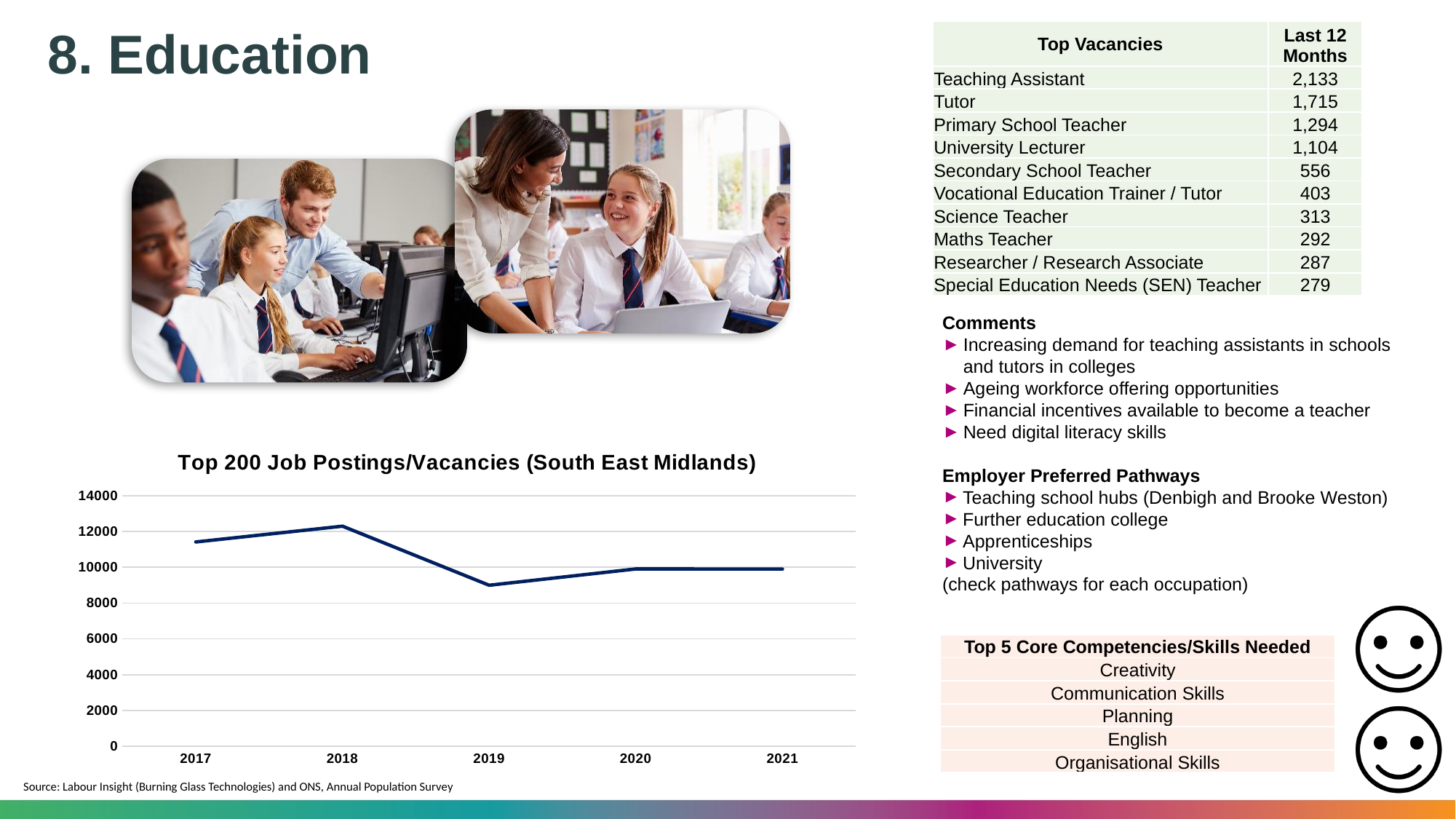
What is the title of the line chart on the slide? Top 200 Job Postings/Vacancies (South East Midlands) In the 'Top 200 Job Postings/Vacancies (South East Midlands)' chart, is the value for 2019 greater or less than 8000? greater In the 'Top 200 Job Postings/Vacancies (South East Midlands)' chart, does the value rise or fall from 2017 to 2018? rise In the 'Top 200 Job Postings/Vacancies (South East Midlands)' chart, which is larger, the value for 2018 or the value for 2019? 2018 In the 'Top 200 Job Postings/Vacancies (South East Midlands)' chart, is the value for 2018 greater or less than 12000? greater In the 'Top 200 Job Postings/Vacancies (South East Midlands)' chart, which year has the highest value? 2018 In the 'Top 200 Job Postings/Vacancies (South East Midlands)' chart, which year has the lowest value? 2019 In the 'Top 200 Job Postings/Vacancies (South East Midlands)' chart, is the value for 2019 greater or less than 10000? less What kind of chart is 'Top 200 Job Postings/Vacancies (South East Midlands)'? line chart How many years are plotted on the x axis of the 'Top 200 Job Postings/Vacancies (South East Midlands)' chart? 5 In the 'Top 200 Job Postings/Vacancies (South East Midlands)' chart, does the value rise or fall from 2018 to 2019? fall